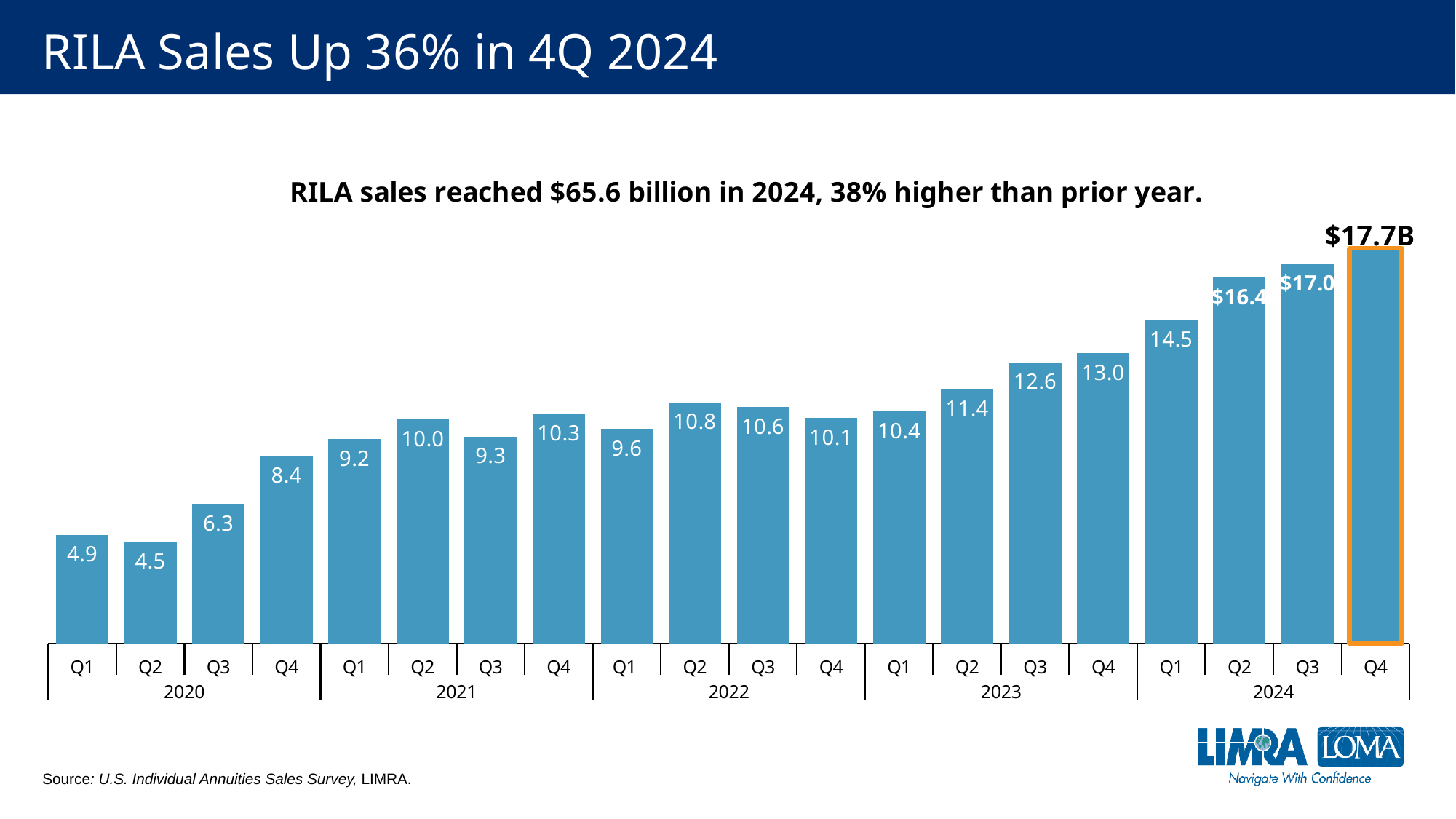
What is the value for Q1 2020? 4.9 What kind of chart is shown on the slide? Bar chart What is the value for Q4 2024? $17.7B What is the value for Q3 2023? 12.6 What is the difference between Q4 2024 and Q3 2024? 0.7 Which is larger, Q3 2022 or Q4 2022? Q3 2022 What is the value for Q2 2021? 10.0 Which quarter has the lowest value? Q2 2020 How many quarterly bars are shown in the chart? 20 Do the values generally rise or fall from Q1 2020 to Q4 2024? Rise Which quarter has the highest value? Q4 2024 What is the difference between Q1 2024 and Q4 2023? 1.5